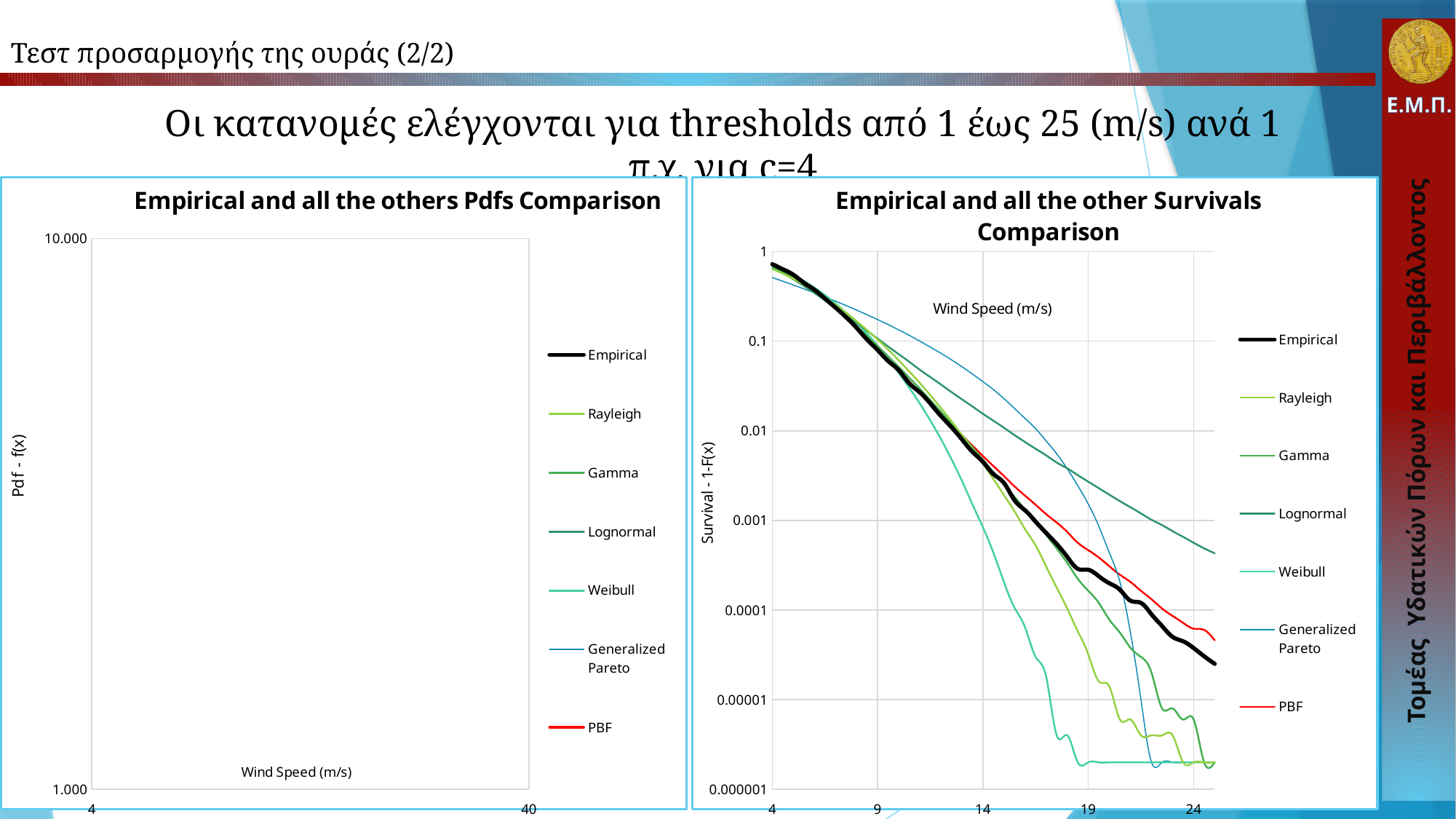
In the right chart, 'Empirical and all the other Survivals Comparison', at a wind speed of 19, which is larger: the Empirical value or the Weibull value? Empirical What is the y-axis label of the right chart, 'Empirical and all the other Survivals Comparison'? Survival - 1-F(x) In the right chart, 'Empirical and all the other Survivals Comparison', do the Empirical values rise or fall as wind speed increases? Fall How many series does the legend of the left chart, 'Empirical and all the others Pdfs Comparison', list? 7 In the right chart, 'Empirical and all the other Survivals Comparison', is the Weibull value at a wind speed of 24 greater or less than 0.00001? less In the right chart, 'Empirical and all the other Survivals Comparison', is the Lognormal value at a wind speed of 24 greater or less than 0.0001? greater What kind of chart is the right chart, 'Empirical and all the other Survivals Comparison'? Line chart In the right chart, 'Empirical and all the other Survivals Comparison', is the Empirical value at a wind speed of 24 greater or less than 0.0001? less How many series does the legend of the right chart, 'Empirical and all the other Survivals Comparison', list? 7 In the right chart, 'Empirical and all the other Survivals Comparison', which series is drawn in red? PBF In the right chart, 'Empirical and all the other Survivals Comparison', which series has the highest value at a wind speed of 24? Lognormal